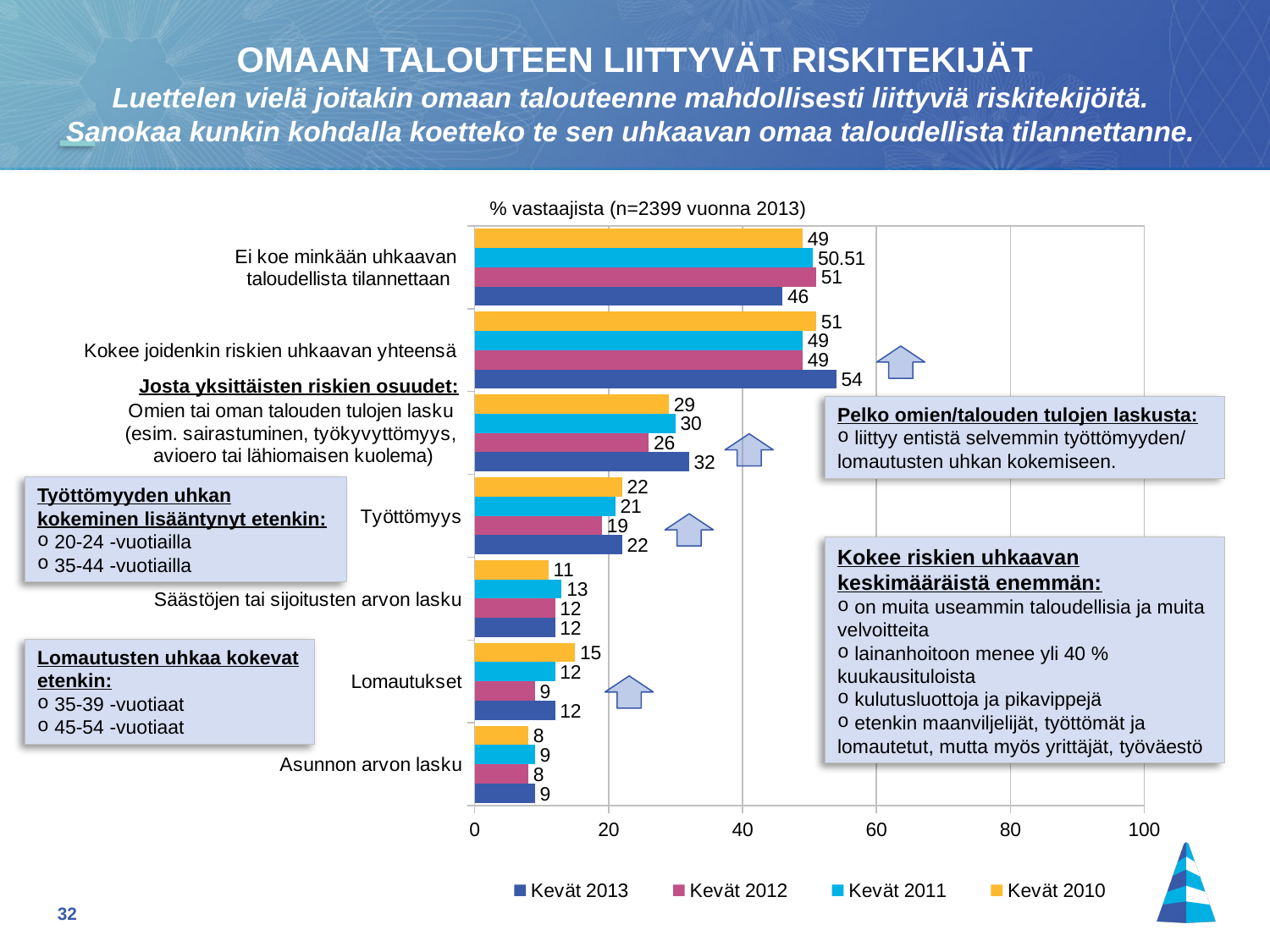
What is the Kevät 2010 value for "Lomautukset"? 15 For "Lomautukset", which is larger: the Kevät 2010 value or the Kevät 2012 value? Kevät 2010 What is the Kevät 2011 value for "Ei koe minkään uhkaavan taloudellista tilannettaan"? 50.51 What is the Kevät 2012 value for "Työttömyys"? 19 For "Omien tai oman talouden tulojen lasku", how much higher is the Kevät 2013 value than the Kevät 2012 value? 6 What is the maximum value shown on the x axis of the chart? 100 Which category has the lowest Kevät 2012 value? Asunnon arvon lasku Which category has the highest Kevät 2013 value? Kokee joidenkin riskien uhkaavan yhteensä How many series does the legend list? 4 How many categories are shown on the chart? 7 What kind of chart is shown on the slide? Bar chart What is the Kevät 2013 value for "Kokee joidenkin riskien uhkaavan yhteensä"? 54